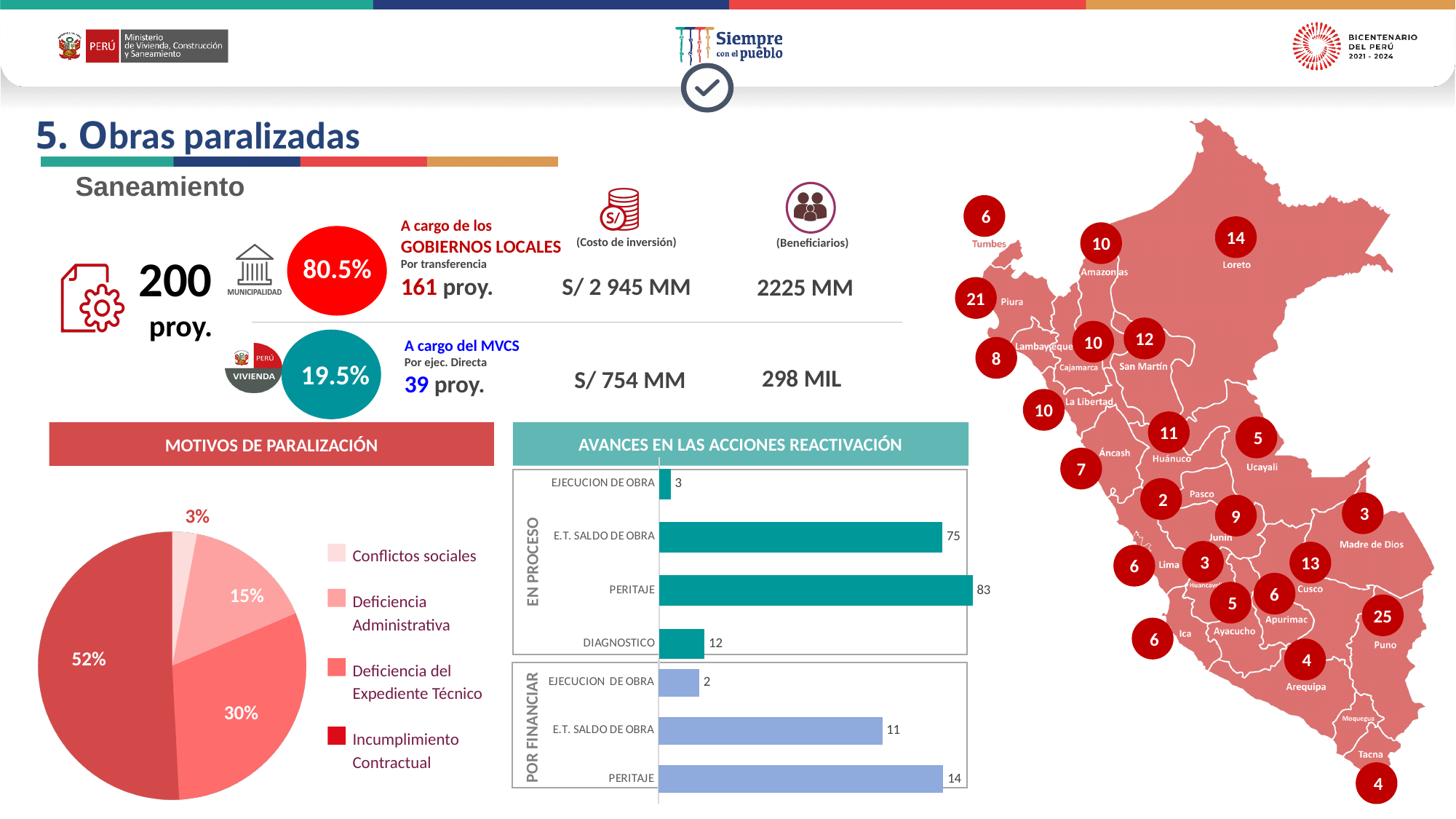
In the 'MOTIVOS DE PARALIZACIÓN' pie chart, which category has the largest slice? Incumplimiento Contractual In the 'MOTIVOS DE PARALIZACIÓN' pie chart, how many categories are shown? 4 In the 'MOTIVOS DE PARALIZACIÓN' pie chart, which category has the smallest slice? Conflictos sociales In the 'MOTIVOS DE PARALIZACIÓN' pie chart, what is the difference between Deficiencia del Expediente Técnico and Deficiencia Administrativa? 15% In the 'MOTIVOS DE PARALIZACIÓN' pie chart, what share does Incumplimiento Contractual have? 52% In the 'AVANCES EN LAS ACCIONES REACTIVACIÓN' chart, which category in the EN PROCESO group has the lowest value? EJECUCION DE OBRA What type of chart is used for 'MOTIVOS DE PARALIZACIÓN'? Pie chart In the 'AVANCES EN LAS ACCIONES REACTIVACIÓN' chart, what is the value for PERITAJE in the EN PROCESO group? 83 In the 'MOTIVOS DE PARALIZACIÓN' pie chart, what share does Deficiencia Administrativa have? 15% In the 'AVANCES EN LAS ACCIONES REACTIVACIÓN' chart, what is the difference between PERITAJE and E.T. SALDO DE OBRA in the EN PROCESO group? 8 In the 'AVANCES EN LAS ACCIONES REACTIVACIÓN' chart, what is the value for E.T. SALDO DE OBRA in the POR FINANCIAR group? 11 In the 'AVANCES EN LAS ACCIONES REACTIVACIÓN' chart, which is larger in the POR FINANCIAR group: PERITAJE or EJECUCION DE OBRA? PERITAJE